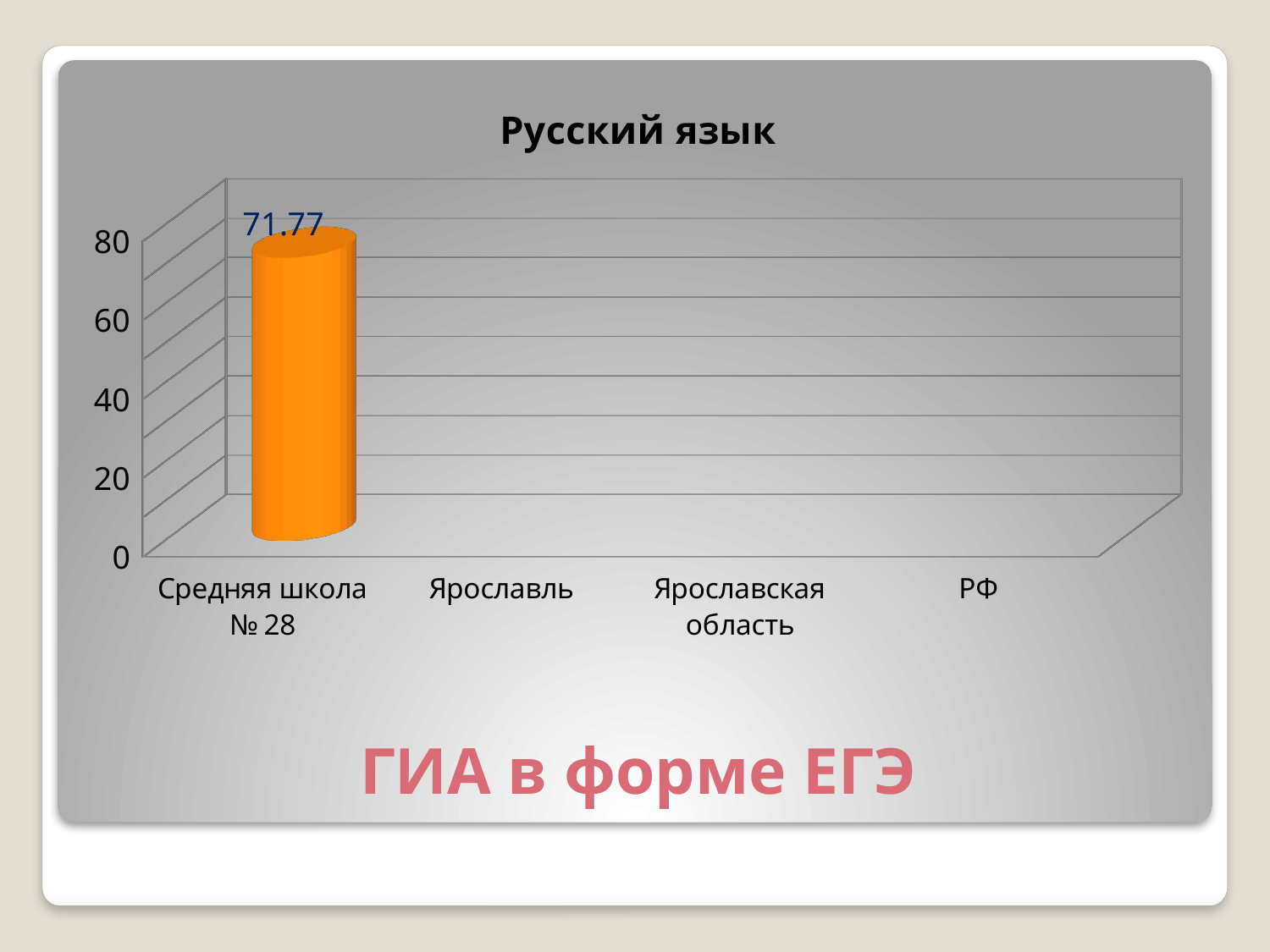
What is the label of the last category on the x axis? РФ Is the value for Средняя школа № 28 greater or less than 60? greater How many categories are listed along the x axis of the chart? 4 How many bars are actually plotted in the chart? 1 What value is shown for Средняя школа № 28 in the chart? 71.77 What colour is the bar for Средняя школа № 28? orange Is the value for Средняя школа № 28 greater or less than 80? less What is the title of the chart? Русский язык Which category has the highest value shown in the chart? Средняя школа № 28 What kind of chart is shown on the slide? bar chart What is the highest tick value shown on the vertical axis? 80